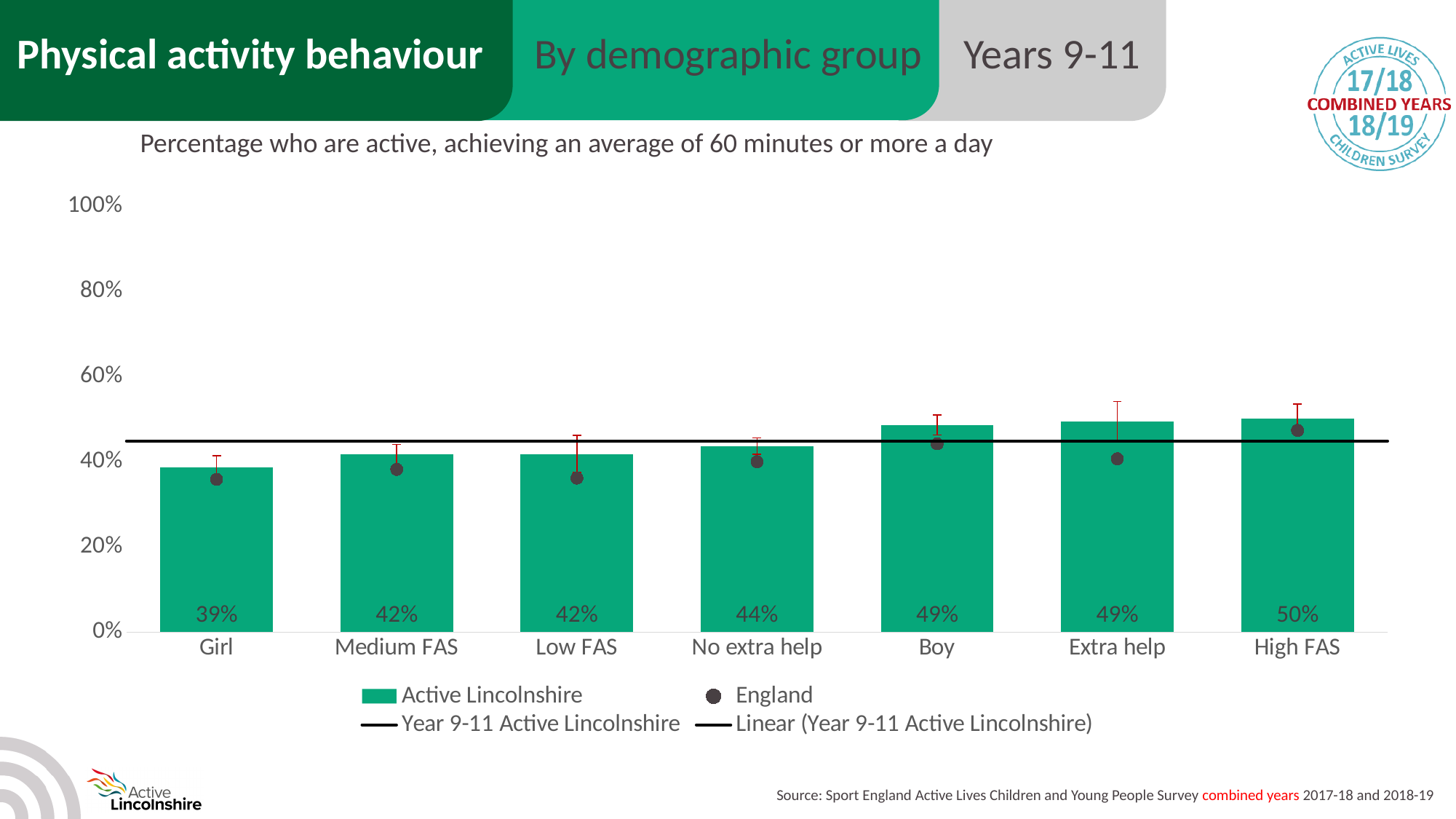
Is the England value for High FAS greater or less than 40%? greater What is the Active Lincolnshire value for Girl? 39% Which demographic group has the highest Active Lincolnshire bar? High FAS How many demographic groups are shown on the x axis? 7 Is the England value for Girl greater or less than 40%? less What is the Active Lincolnshire value for No extra help? 44% What is the difference between the Active Lincolnshire values for High FAS and Girl? 11 percentage points How many entries does the legend list? 4 What is the Active Lincolnshire value for High FAS? 50% Which has a higher Active Lincolnshire value, Boy or Girl? Boy Do the Active Lincolnshire bar values rise or fall from left to right across the x axis? rise Which demographic group has the lowest Active Lincolnshire bar? Girl